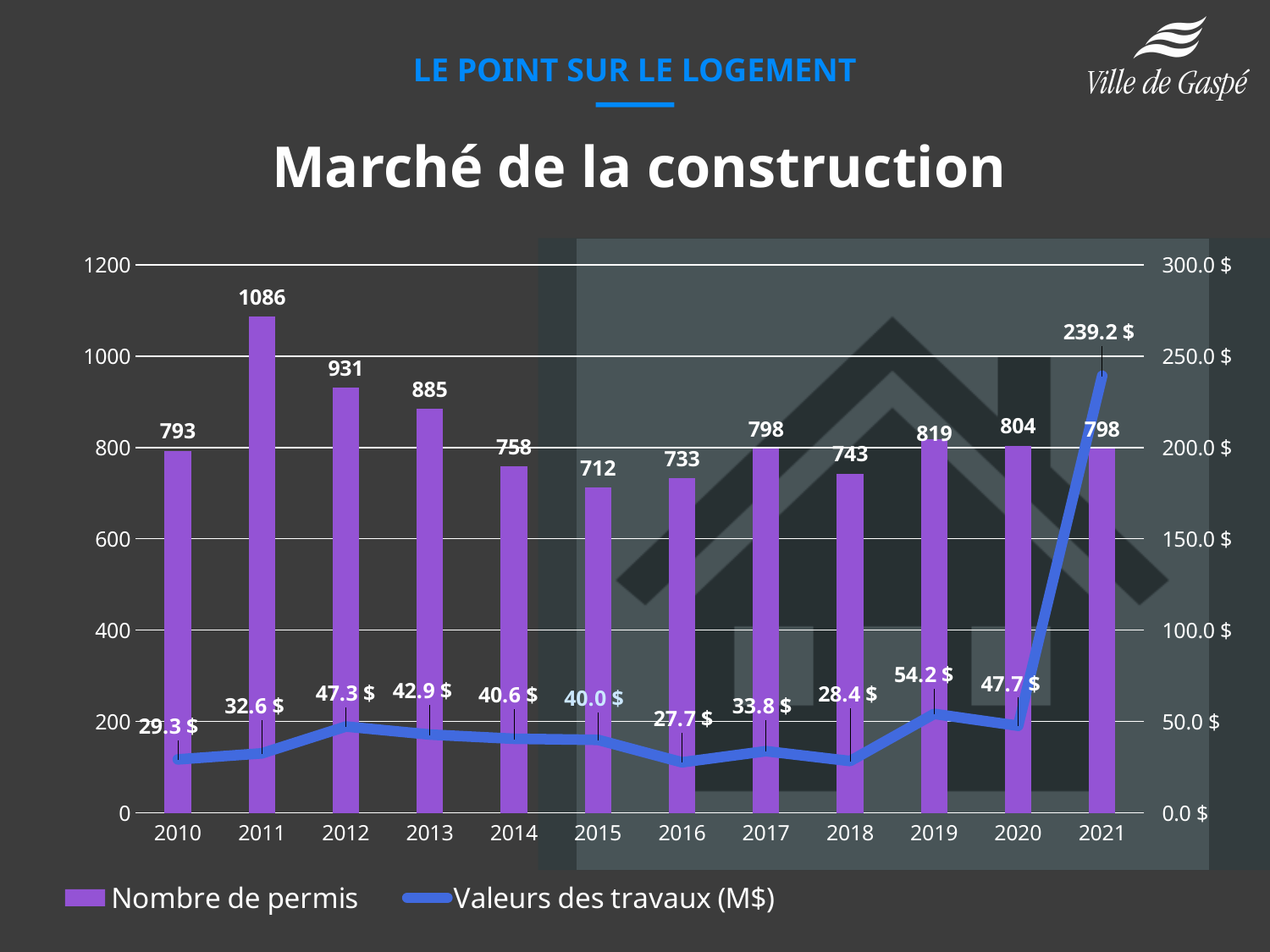
Which is larger, the 'Nombre de permis' for 2019 or for 2020? 2019 Which year has the highest 'Nombre de permis'? 2011 What kind of chart is used for 'Nombre de permis'? bar chart How many years are shown on the x axis? 12 What is the value of 'Valeurs des travaux (M$)' for 2021? 239.2 $ What is the title of the chart? Marché de la construction What is the value of 'Nombre de permis' for 2011? 1086 Which year has the lowest 'Valeurs des travaux (M$)'? 2016 Which year has the lowest 'Nombre de permis'? 2015 How many series does the legend list? 2 What is the value of 'Valeurs des travaux (M$)' for 2016? 27.7 $ What is the difference in 'Nombre de permis' between 2011 and 2012? 155